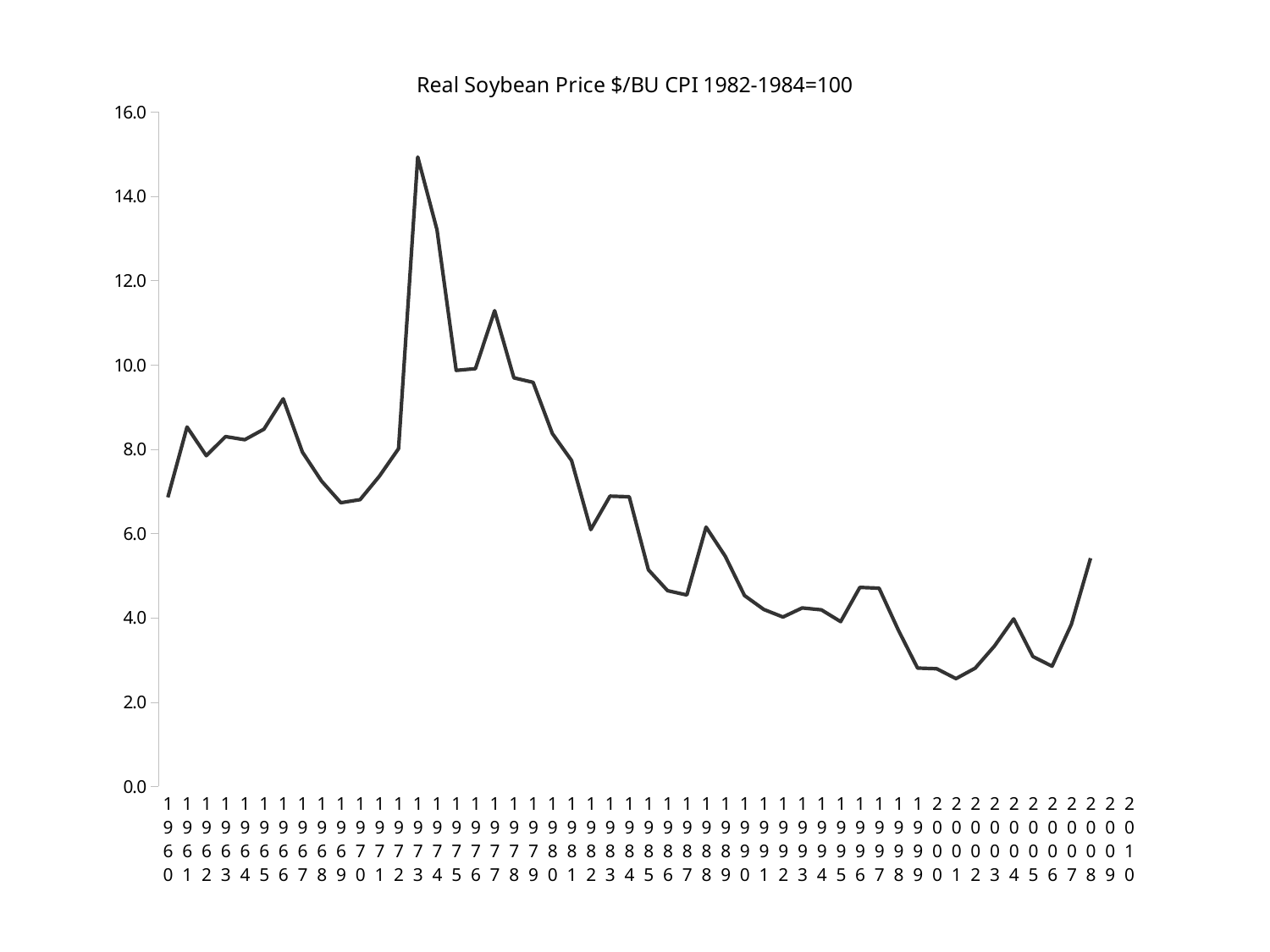
Is the value for 1973 greater or less than 14.0? greater Is the value for 1977 greater or less than 10.0? greater Which year has the higher real soybean price, 1973 or 1977? 1973 Is the value for 1960 greater or less than 8.0? less What is the title of the chart? Real Soybean Price $/BU CPI 1982-1984=100 What kind of chart is shown on the slide? line chart Which year has the higher real soybean price, 1980 or 1990? 1980 In which year does the real soybean price reach its highest point? 1973 Does the real soybean price generally rise or fall between 1980 and 2001? fall